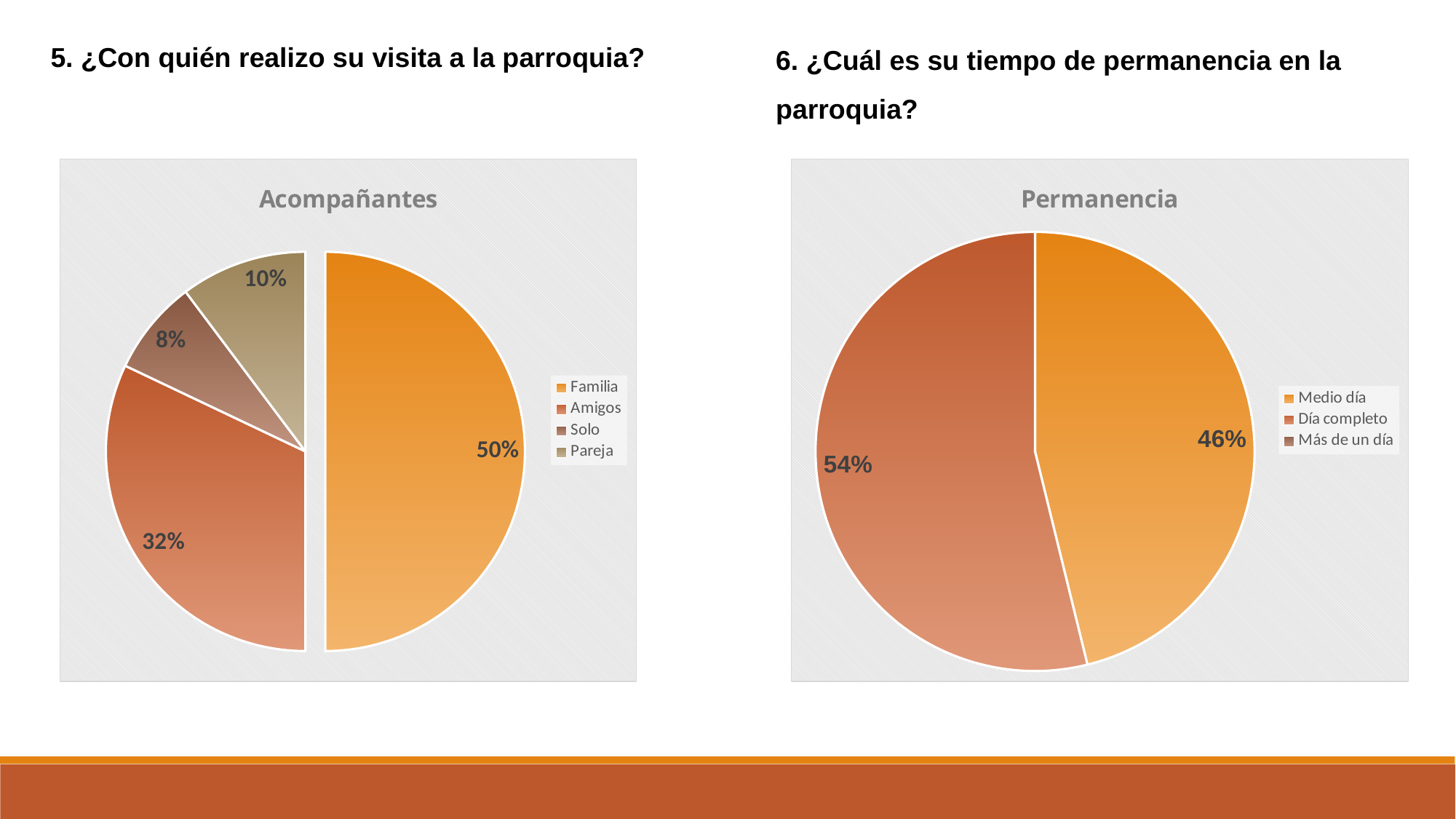
In the Permanencia chart, what percentage is shown for Día completo? 54% In the Acompañantes chart, how many categories does the legend list? 4 In the Acompañantes chart, which category has the largest slice? Familia In the Permanencia chart, how many entries does the legend list? 3 In the Permanencia chart, which is larger, Medio día or Día completo? Día completo In the Permanencia chart, what percentage is shown for Medio día? 46% In the Acompañantes chart, what percentage is shown for Pareja? 10% In the Acompañantes chart, what percentage is shown for Amigos? 32% What type of chart is the Permanencia chart? Pie chart In the Acompañantes chart, what percentage is shown for Familia? 50% In the Acompañantes chart, what is the difference between the Familia and Amigos percentages? 18% In the Acompañantes chart, which category has the smallest slice? Solo